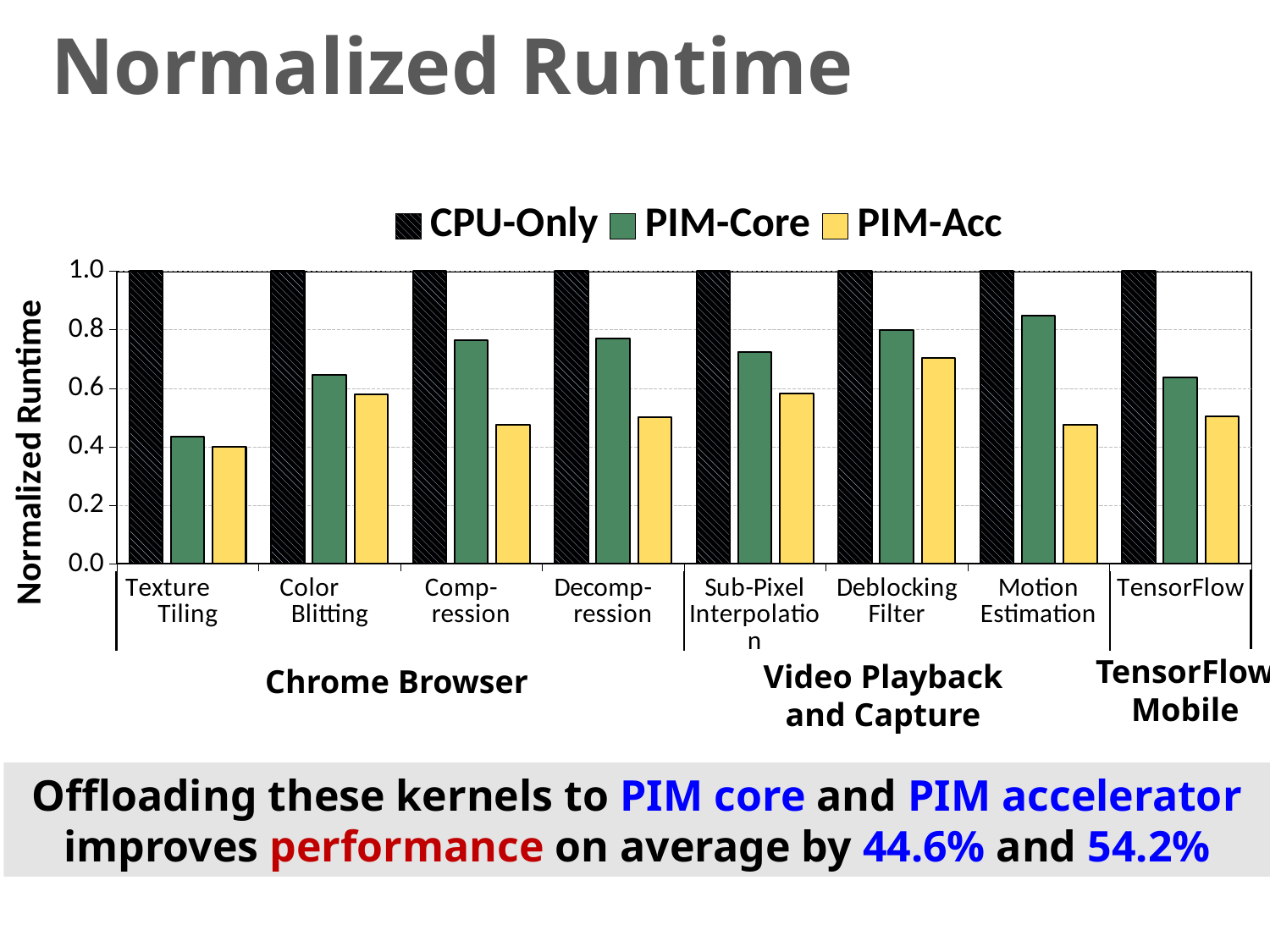
Is the PIM-Acc normalized runtime for Deblocking Filter greater or less than 0.6? greater Which kernel has the lowest PIM-Acc normalized runtime? Texture Tiling What kind of chart is shown on the slide? Bar chart Which kernel has the lowest PIM-Core normalized runtime? Texture Tiling Which kernel has the highest PIM-Acc normalized runtime? Deblocking Filter What is the CPU-Only normalized runtime for Texture Tiling? 1.0 Is the PIM-Core normalized runtime for Texture Tiling greater or less than 0.6? less Is the PIM-Acc normalized runtime for Compression greater or less than 0.6? less How many series does the legend list? 3 What is the CPU-Only normalized runtime for TensorFlow? 1.0 How many kernels (categories) are shown on the x axis? 8 For Motion Estimation, which is larger: the PIM-Core or the PIM-Acc normalized runtime? PIM-Core